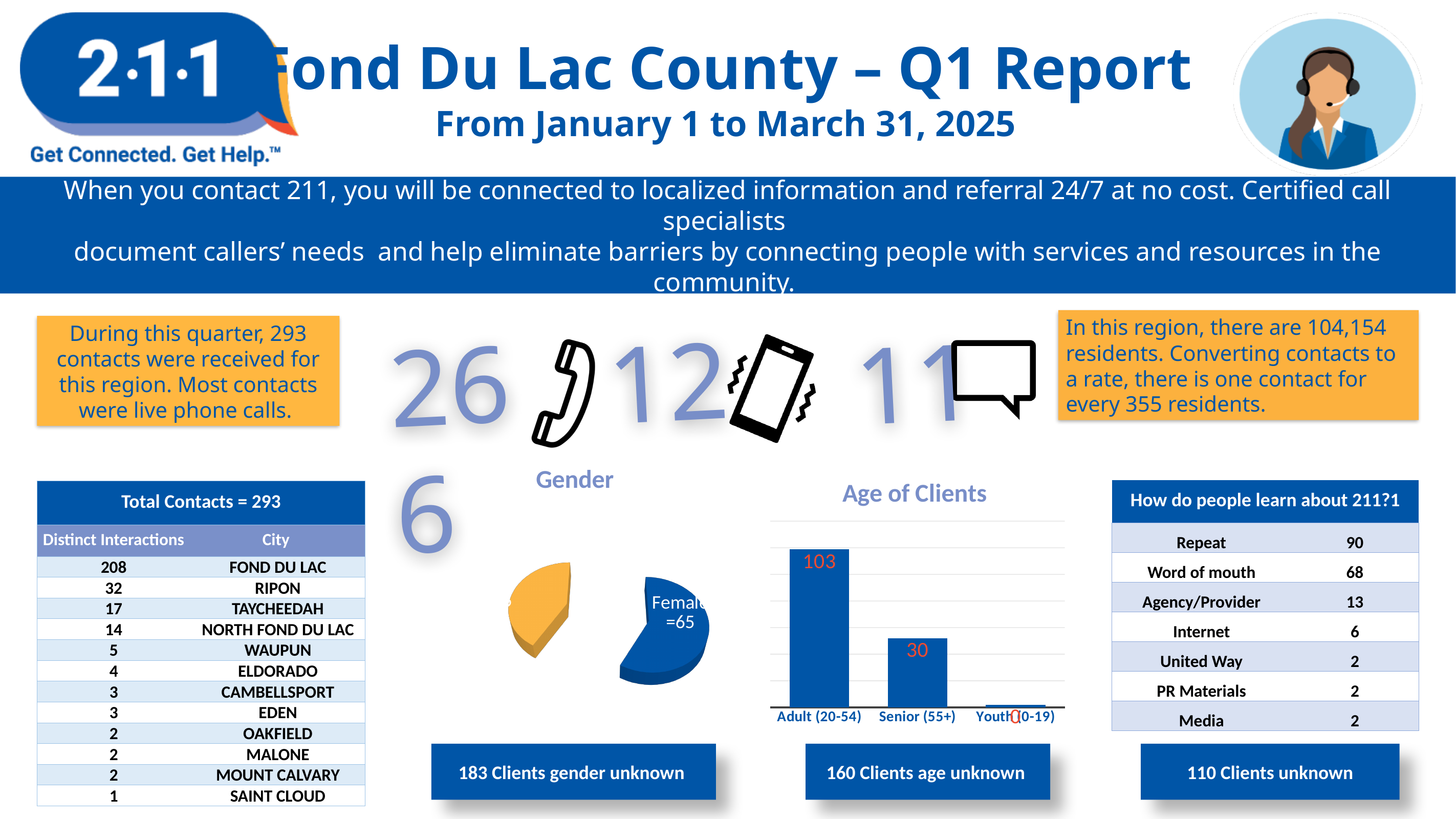
What kind of chart is the Gender chart? Pie chart What kind of chart is the Age of Clients chart? Bar chart In the Age of Clients chart, do the values rise or fall from left to right along the x axis? Fall In the Age of Clients chart, which age group has the highest value? Adult (20-54) In the Age of Clients chart, which is larger: Senior (55+) or Youth (0-19)? Senior (55+) In the Age of Clients chart, what is the value for Youth (0-19)? 0 In the Age of Clients chart, what is the value for Senior (55+)? 30 In the Age of Clients chart, which age group has the lowest value? Youth (0-19) In the Gender chart, what is the value for Female? 65 How many age groups are shown in the Age of Clients chart? 3 In the Age of Clients chart, what is the value for Adult (20-54)? 103 In the Age of Clients chart, what is the difference between the Adult (20-54) and Senior (55+) values? 73